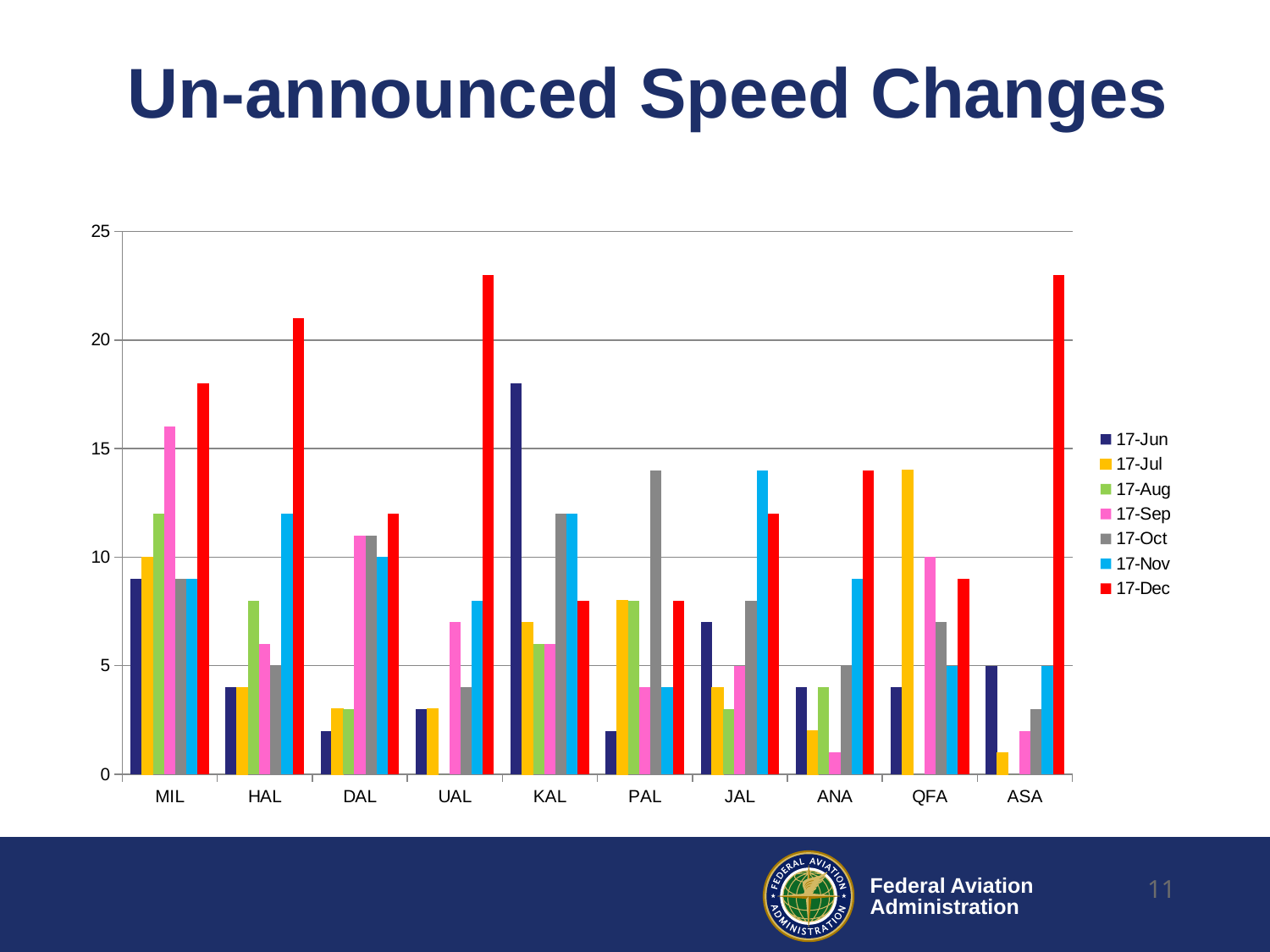
How many series does the legend list? 7 Is the 17-Jun value for DAL greater or less than 5? less What kind of chart is shown on the slide? bar chart What is the title of the chart? Un-announced Speed Changes Which series has the highest value for QFA? 17-Jul How many categories are shown on the x axis? 10 Which series has the lowest value for ASA? 17-Aug Which series has the highest value for MIL? 17-Dec Which is larger, the 17-Jun value for KAL or the 17-Jun value for JAL? KAL Which is larger, the 17-Dec value for HAL or the 17-Dec value for MIL? HAL Is the 17-Dec value for HAL greater or less than 20? greater Which series has the highest value for KAL? 17-Jun